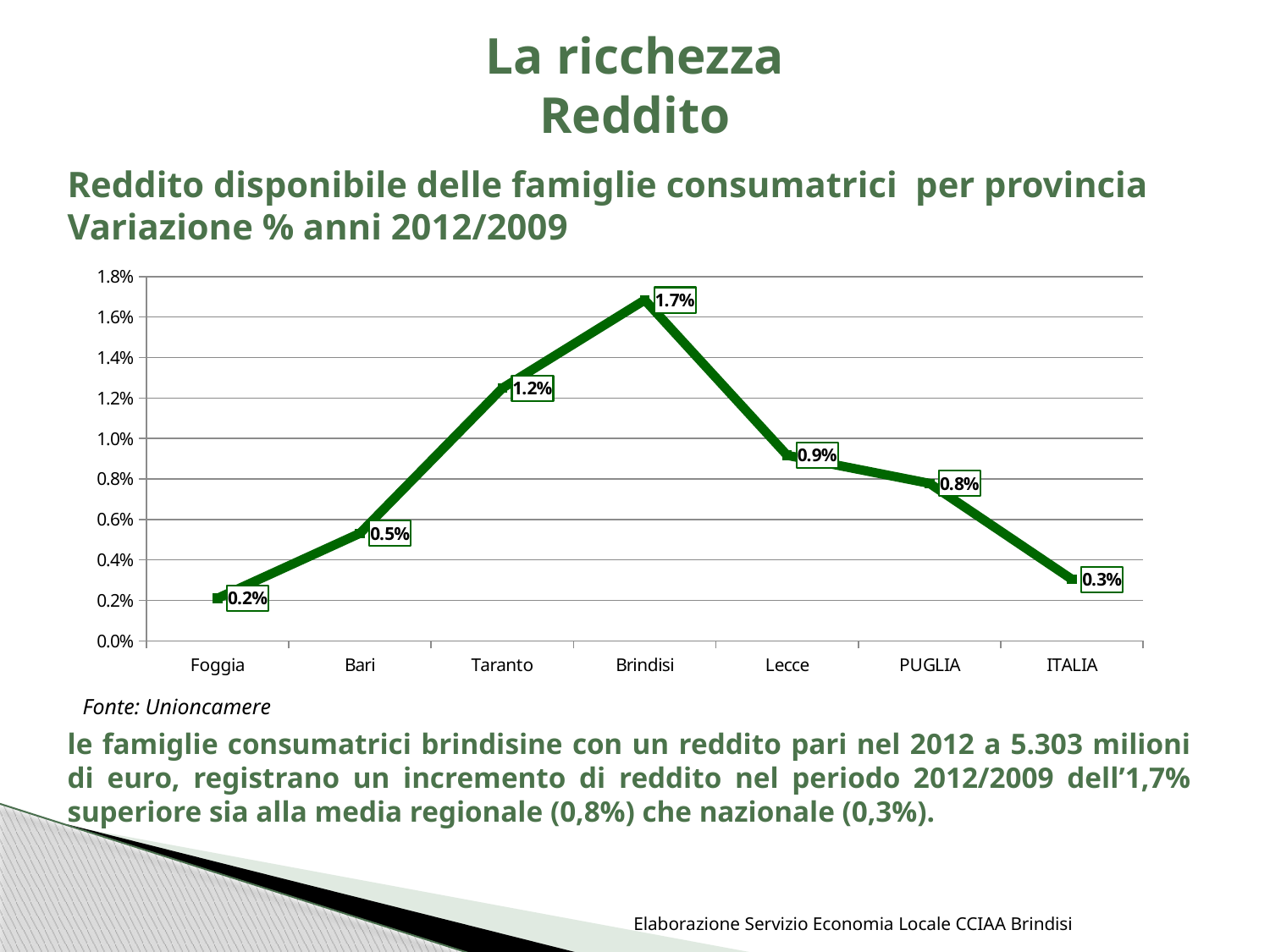
Which category has the highest value? Brindisi What is the value for ITALIA? 0.3% What is the value for Brindisi? 1.7% What is the value for PUGLIA? 0.8% Which category has the lowest value? Foggia Do the values rise or fall from Brindisi to ITALIA? Fall What kind of chart is shown on the slide? Line chart How many categories are plotted on the x axis? 7 What is the difference between the values for Brindisi and PUGLIA? 0.9% What is the source cited below the chart? Unioncamere What is the value for Foggia? 0.2% Which is larger, the value for Taranto or the value for Lecce? Taranto